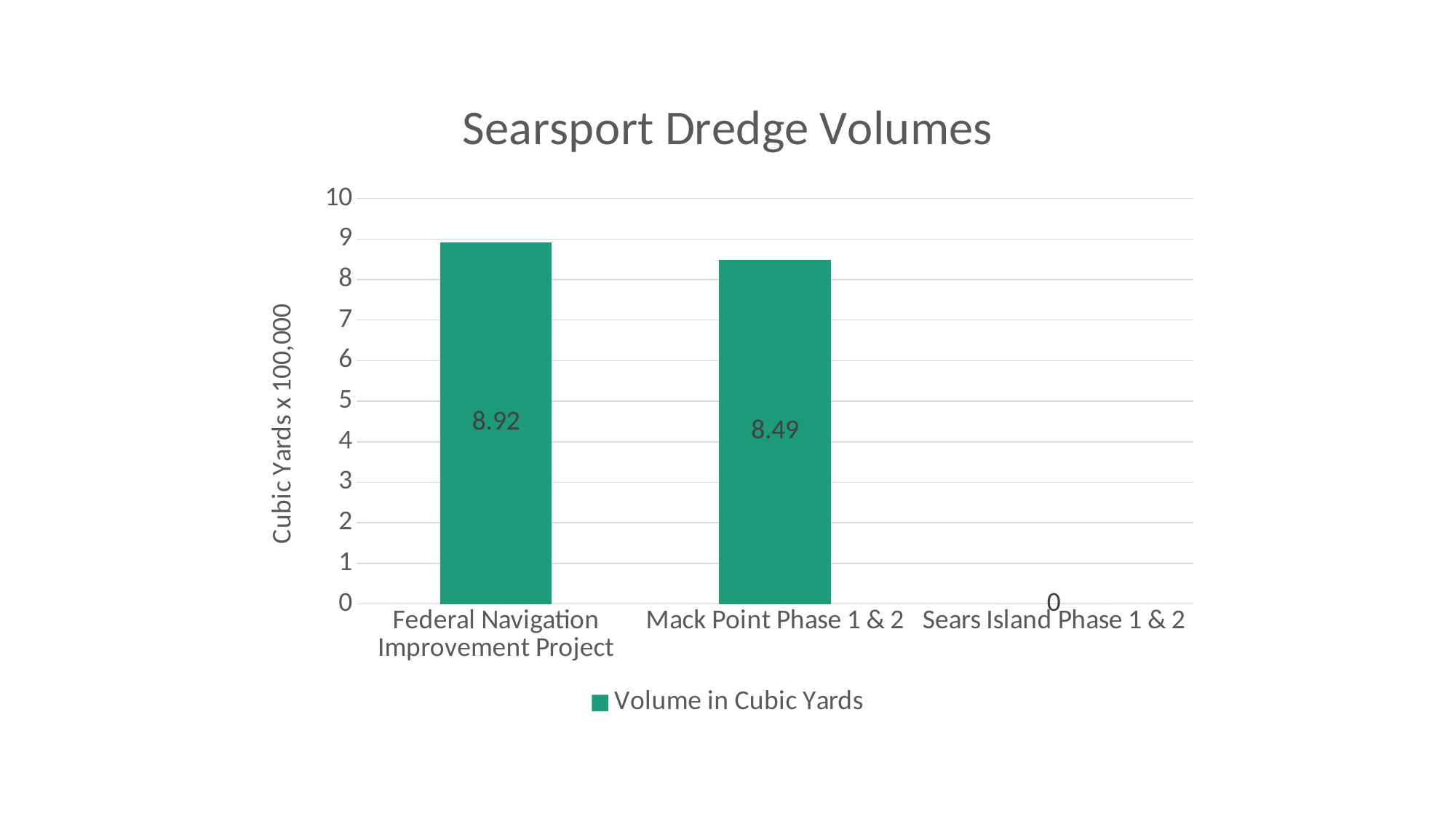
What is the value for Sears Island Phase 1 & 2? 0 Which category has the highest value? Federal Navigation Improvement Project Is the value for Mack Point Phase 1 & 2 greater or less than 8? greater How many categories are shown on the x axis? 3 What is the value for Mack Point Phase 1 & 2? 8.49 What is the title of the chart? Searsport Dredge Volumes What kind of chart is this? bar chart What is the difference between the values for Federal Navigation Improvement Project and Mack Point Phase 1 & 2? 0.43 Which is larger, the value for Federal Navigation Improvement Project or the value for Mack Point Phase 1 & 2? Federal Navigation Improvement Project Which category has the lowest value? Sears Island Phase 1 & 2 How many series does the legend list? 1 What is the value for Federal Navigation Improvement Project? 8.92